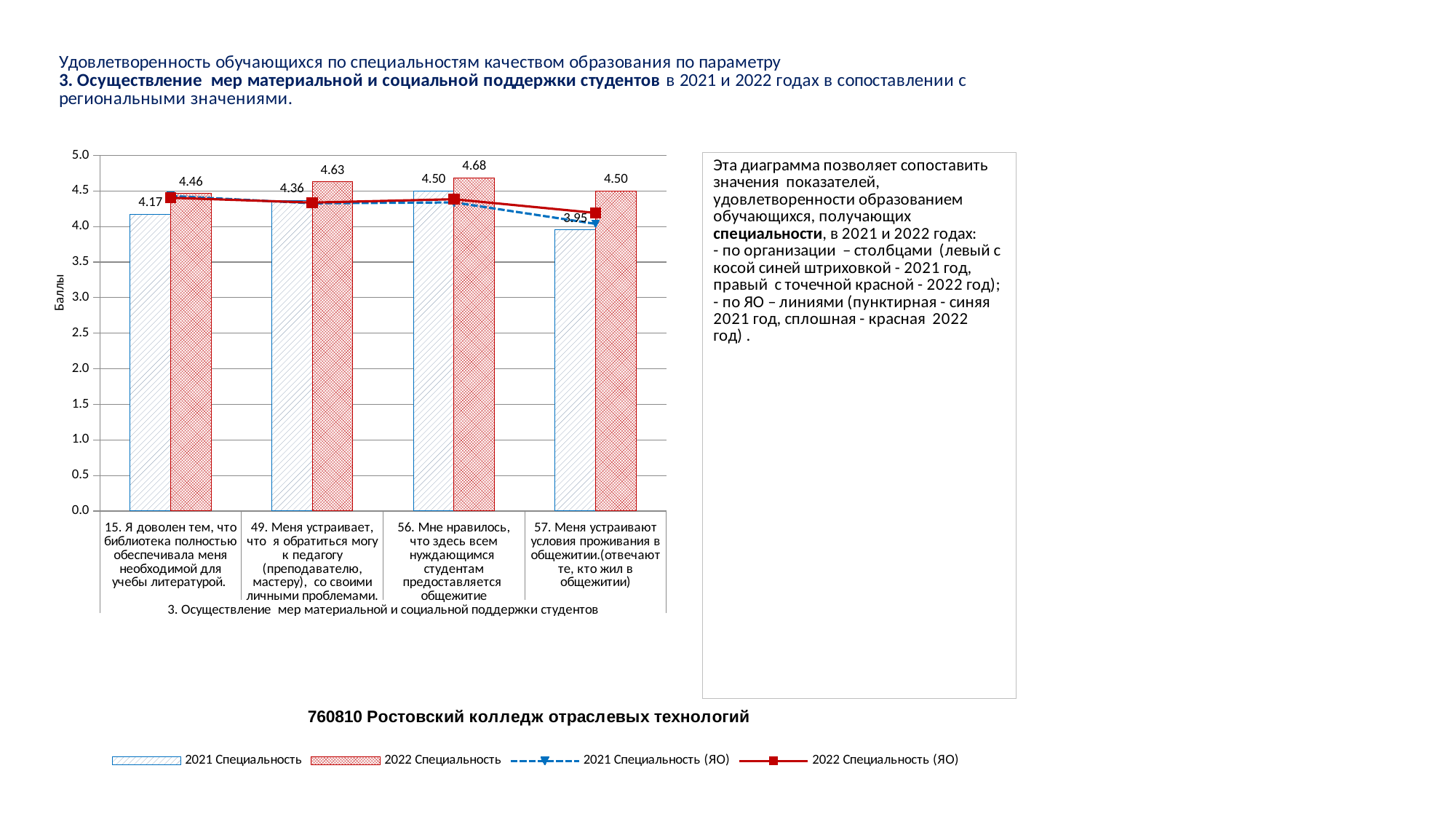
What is the value of the 2022 Специальность bar for question 15 (library literature)? 4.46 What kind of chart is shown on the slide? Combined bar and line chart Which is larger for question 49: the 2021 Специальность bar or the 2022 Специальность bar? 2022 Специальность What is the label of the y axis? Баллы How many categories are shown on the x axis? 4 Which category has the lowest 2021 Специальность bar? 57. Меня устраивают условия проживания в общежитии What is the value of the 2022 Специальность bar for question 56 (dormitory provided to students in need)? 4.68 What is the difference between the 2022 and 2021 Специальность bars for question 57? 0.55 Which category has the highest 2022 Специальность bar? 56. Мне нравилось, что здесь всем нуждающимся студентам предоставляется общежитие How many series does the legend list? 4 Is the 2021 Специальность value for question 57 greater or less than 4.0? less What is the value of the 2021 Специальность bar for question 57 (dormitory living conditions)? 3.95